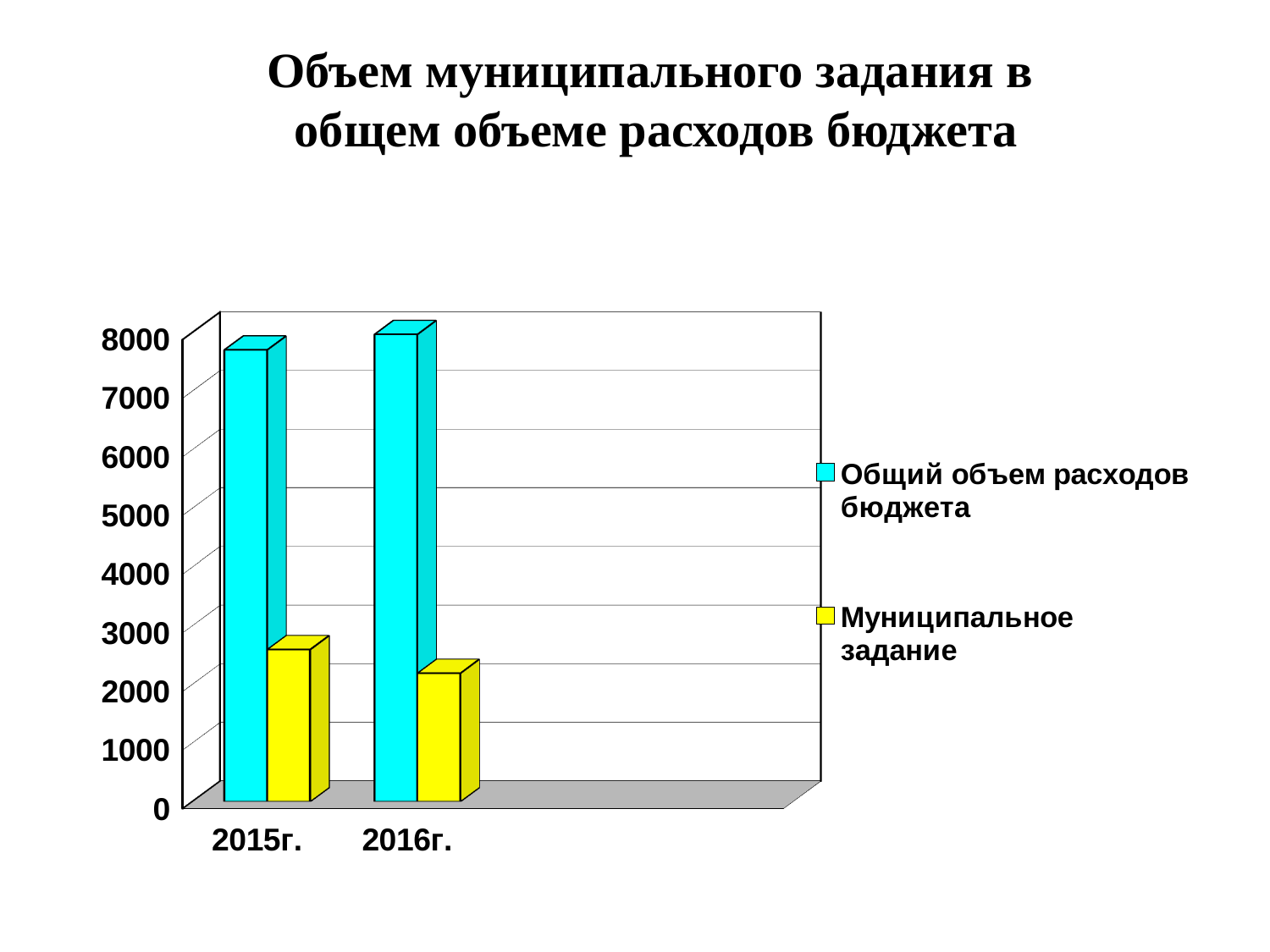
How many series does the legend list? 2 Is the value of "Общий объем расходов бюджета" for 2015г. greater or less than 7000? greater What kind of chart is shown on the slide? bar chart Does the value of "Муниципальное задание" rise or fall from 2015г. to 2016г.? fall How many categories (years) are shown on the x axis? 2 Is the value of "Муниципальное задание" for 2015г. greater or less than 3000? less Which colour represents the series "Муниципальное задание" in the legend? yellow What is the title of the chart on the slide? Объем муниципального задания в общем объеме расходов бюджета Is the value of "Муниципальное задание" for 2016г. greater or less than 3000? less Does the value of "Общий объем расходов бюджета" rise or fall from 2015г. to 2016г.? rise Which year has the larger value for "Муниципальное задание", 2015г. or 2016г.? 2015г.